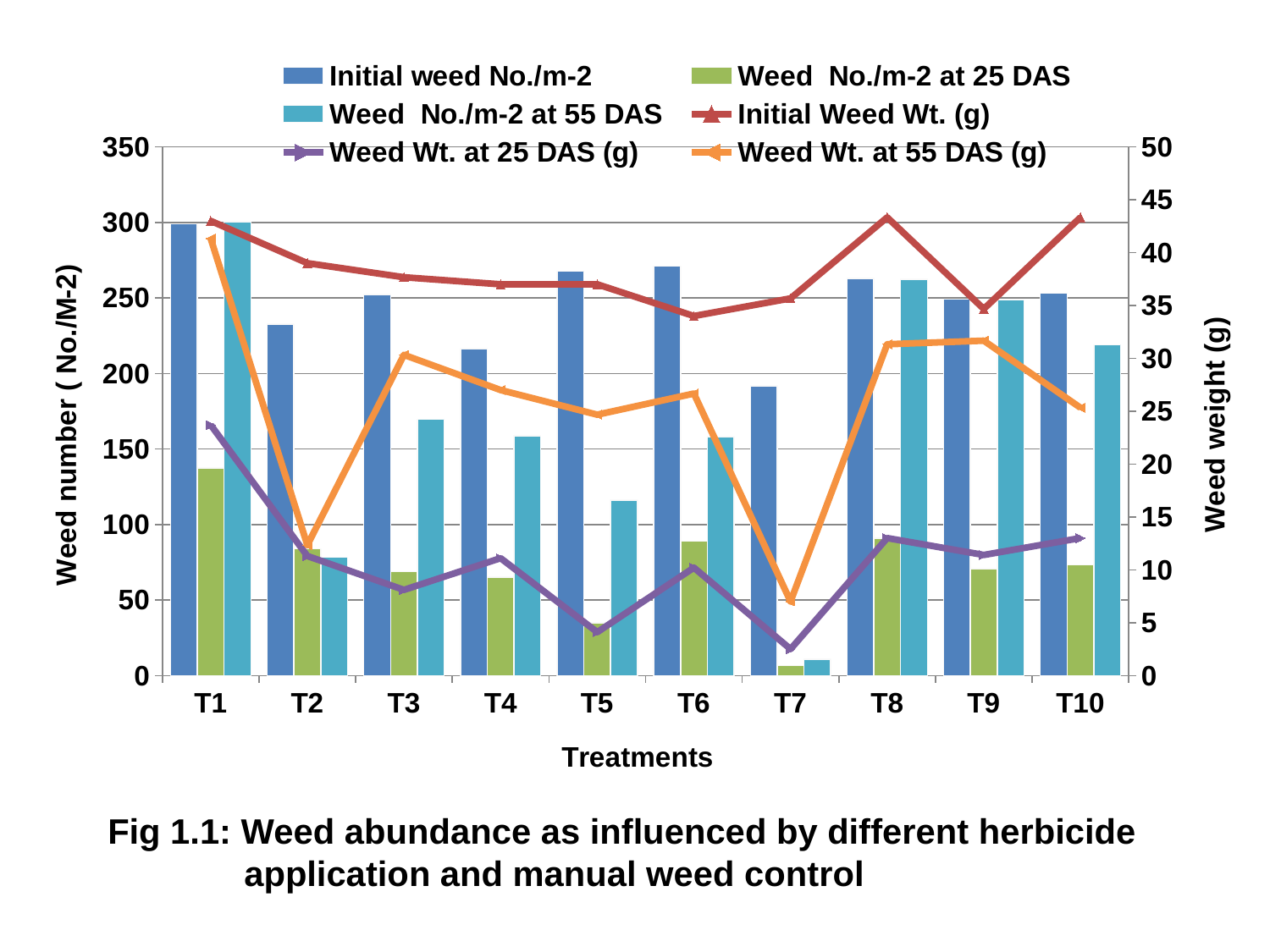
How many treatments are shown on the x axis? 10 What kind of chart is this? Combined bar and line chart Which treatment has the highest Initial weed No./m-2? T1 Is the Initial weed No./m-2 for T7 greater or less than 200? less Is the Weed No./m-2 at 55 DAS for T10 greater or less than 200? greater Which treatment has the lowest Initial weed No./m-2? T7 Which is larger, the Weed No./m-2 at 25 DAS for T1 or for T2? T1 Which treatment has the lowest Weed No./m-2 at 55 DAS? T7 How many series does the legend list? 6 Which treatment has the highest Weed Wt. at 25 DAS (g)? T1 Which treatment has the lowest Weed No./m-2 at 25 DAS? T7 Is the Weed Wt. at 55 DAS (g) for T7 greater or less than 10? less